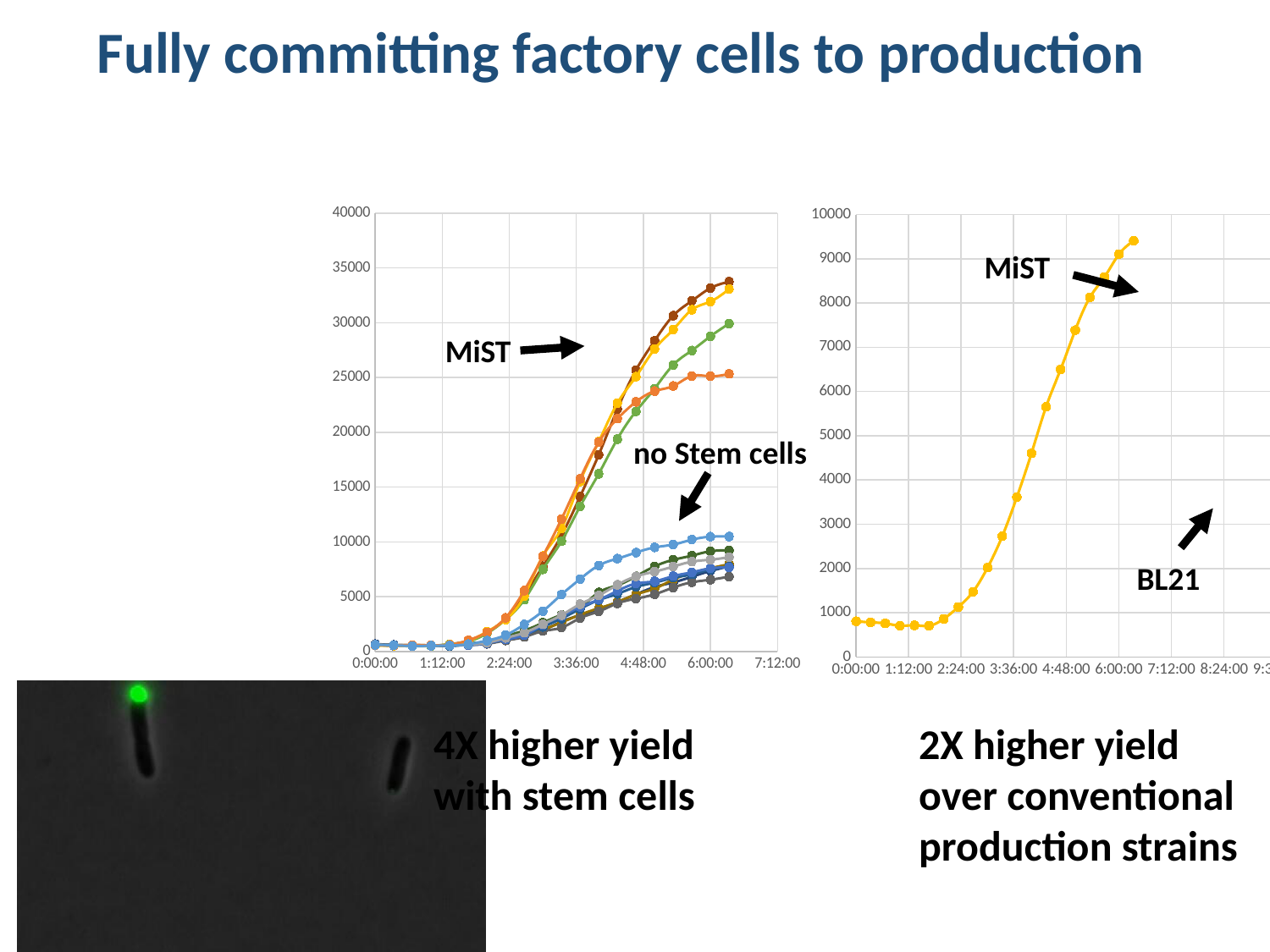
In the right chart, is the final value of the MiST line greater or less than 9000? greater In the left chart, which group of lines reaches higher values, MiST or 'no Stem cells'? MiST What kind of chart is the left chart on the slide? line chart In the right chart, does the MiST line rise or fall over time along the x axis? rise In the left chart, do the MiST lines rise or fall over time along the x axis? rise In the left chart, are the final values of the 'no Stem cells' lines greater or less than 15000? less What is the maximum value shown on the y axis of the right chart? 10000 What is the maximum value shown on the y axis of the left chart? 40000 What kind of chart is the right chart on the slide? line chart In the right chart, is the MiST value at 3:36:00 greater or less than 4000? less